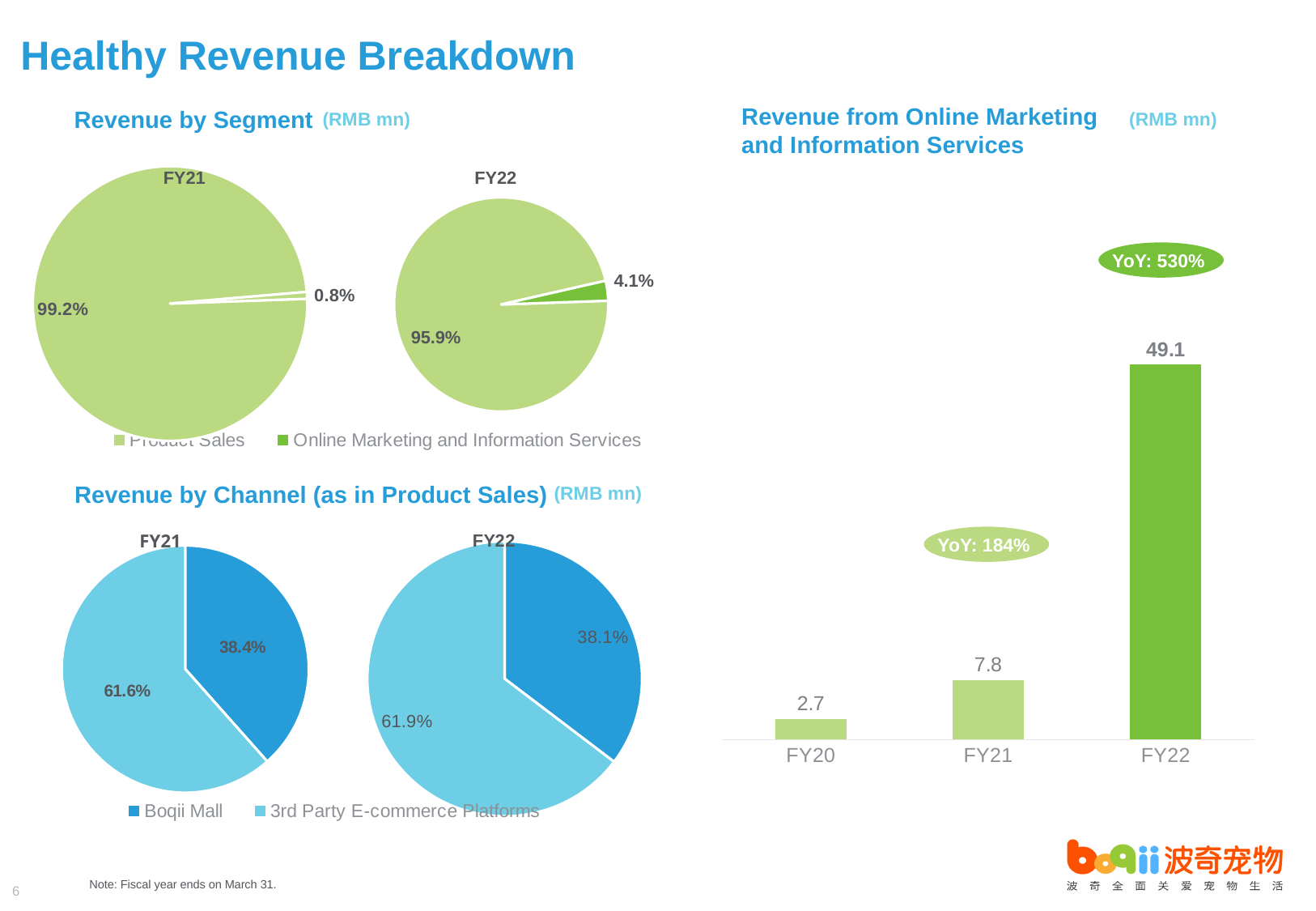
What kind of chart is the Revenue from Online Marketing and Information Services chart? bar chart In the Revenue by Segment FY21 pie chart, what share does Product Sales have? 99.2% In the Revenue from Online Marketing and Information Services bar chart, what is the difference between the FY22 and FY21 values? 41.3 In the Revenue by Channel FY22 pie chart, what share do 3rd Party E-commerce Platforms have? 61.9% In the Revenue from Online Marketing and Information Services bar chart, what is the value for FY20? 2.7 In the Revenue from Online Marketing and Information Services bar chart, which fiscal year has the highest value? FY22 In the Revenue by Channel FY21 pie chart, which is larger, Boqii Mall or 3rd Party E-commerce Platforms? 3rd Party E-commerce Platforms In the Revenue by Segment FY22 pie chart, what share does Online Marketing and Information Services have? 4.1% In the Revenue from Online Marketing and Information Services bar chart, what is the value for FY22? 49.1 In the Revenue from Online Marketing and Information Services bar chart, how many fiscal years are shown? 3 In the Revenue from Online Marketing and Information Services bar chart, do the values rise or fall from FY20 to FY22? rise In the Revenue from Online Marketing and Information Services bar chart, which fiscal year has the lowest value? FY20